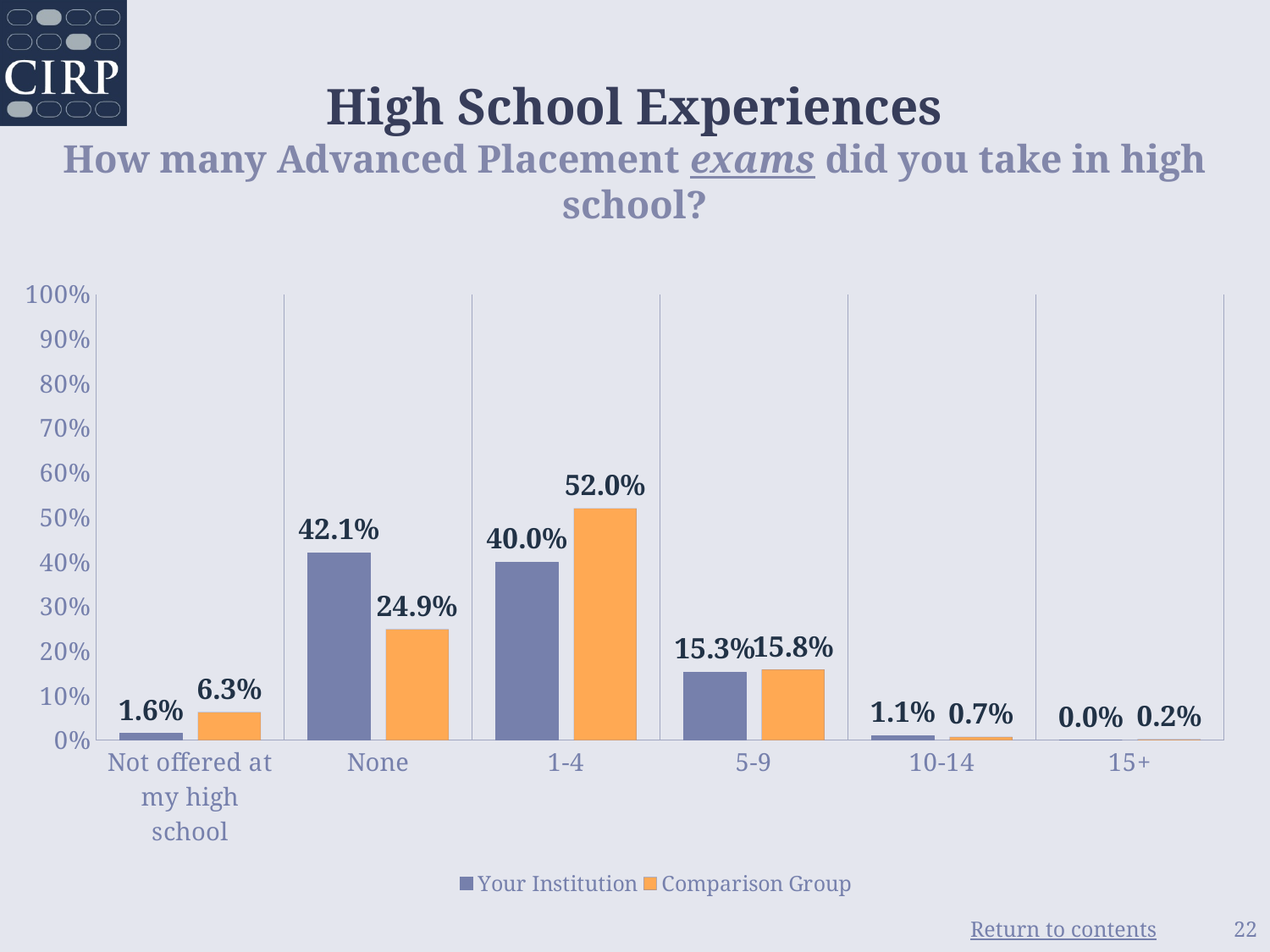
How many categories are shown on the x axis? 6 What is the difference between the Comparison Group and Your Institution values for the 1-4 category? 12.0% Which category has the lowest value for Your Institution? 15+ What is the Your Institution value for 'Not offered at my high school'? 1.6% What is the Comparison Group value for the 'None' category? 24.9% What type of chart is shown on the slide? Bar chart What colour represents the Comparison Group series? Orange Which category has the highest value for the Comparison Group? 1-4 Which is larger for the 'None' category: Your Institution or Comparison Group? Your Institution What percentage of Your Institution respondents took 1-4 Advanced Placement exams? 40.0% Which category has the highest value for Your Institution? None How many series does the legend list? 2